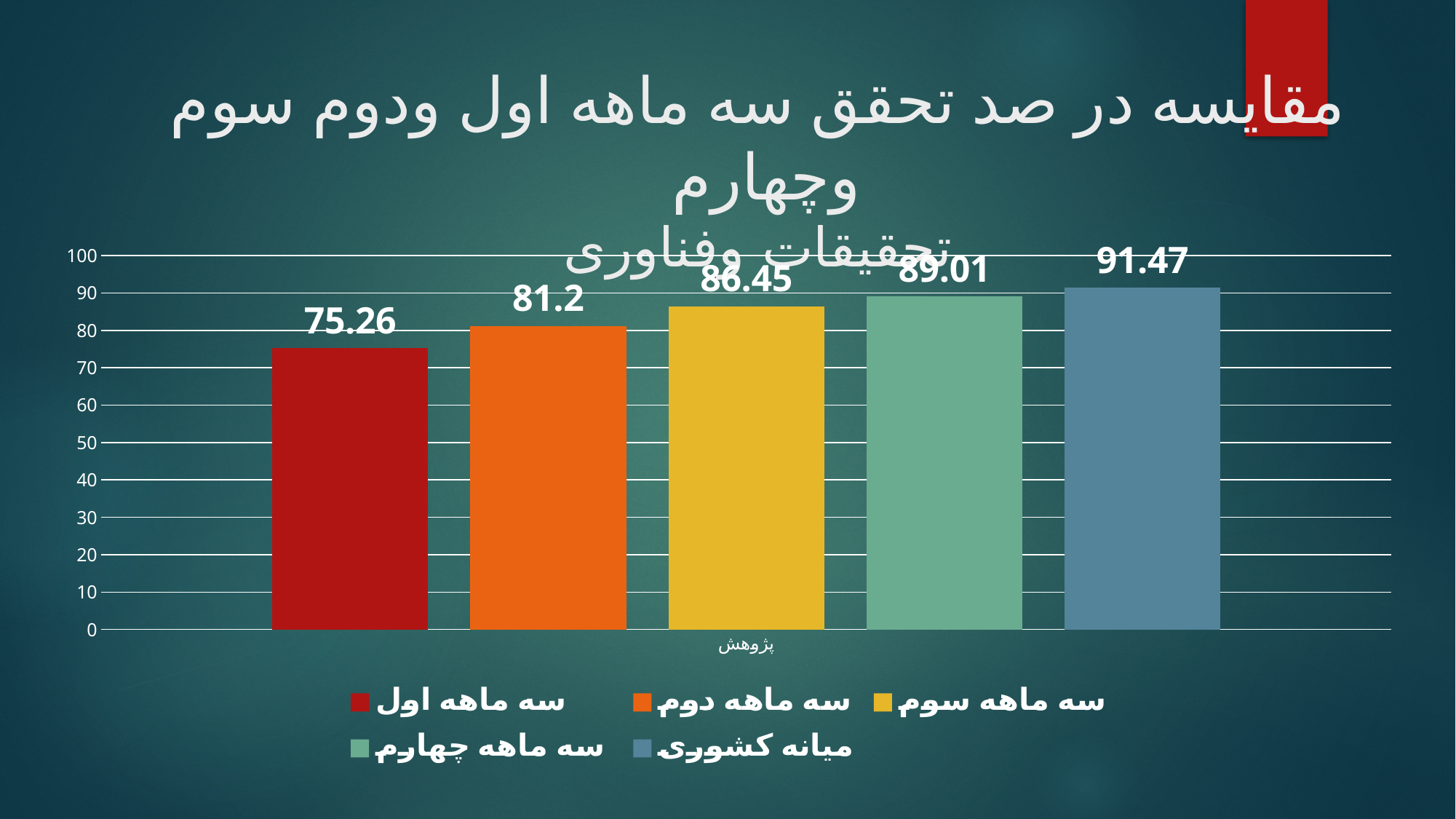
What kind of chart is shown on the slide? bar chart Which series has the lowest value? سه ماهه اول Which series has the highest value? میانه کشوری What is the category label shown on the x axis below the bars? پژوهش What is the value shown for سه ماهه سوم? 86.45 Is the value for سه ماهه دوم greater or less than 90? less What is the value shown for میانه کشوری? 91.47 Which is larger, the value for سه ماهه دوم or the value for سه ماهه چهارم? سه ماهه چهارم What is the difference between the values for میانه کشوری and سه ماهه سوم? 5.02 What is the value shown for سه ماهه اول? 75.26 What is the difference between the values for سه ماهه چهارم and سه ماهه اول? 13.75 How many series does the legend list? 5